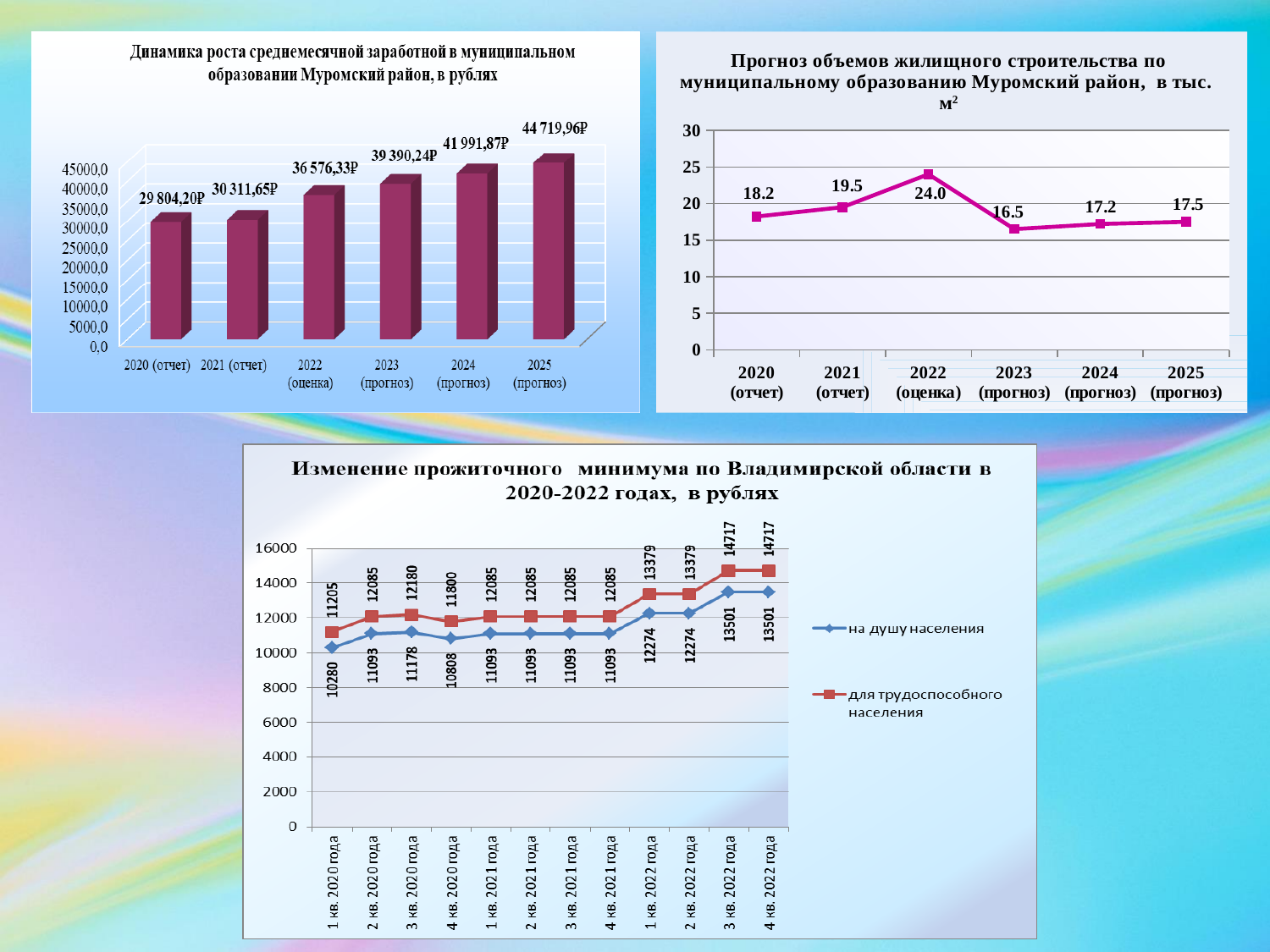
In the top-right chart (Прогноз объемов жилищного строительства), what is the difference between the 2022 value and the 2023 value? 7.5 In the top-right chart (Прогноз объемов жилищного строительства), which year has the highest value? 2022 (оценка) In the bottom chart (Изменение прожиточного минимума), what is the value for 'для трудоспособного населения' in 3 кв. 2022 года? 14717 In the top-right chart (Прогноз объемов жилищного строительства), what is the value for 2021 (отчет)? 19.5 In the top-right chart (Прогноз объемов жилищного строительства), which year has the lowest value? 2023 (прогноз) In the top-left chart (Динамика роста среднемесячной заработной платы), how many bars are plotted? 6 In the bottom chart (Изменение прожиточного минимума), how many series does the legend list? 2 In the top-left chart (Динамика роста среднемесячной заработной платы), do the values rise or fall from 2020 to 2025? Rise In the top-left chart (Динамика роста среднемесячной заработной платы), what is the value for 2025 (прогноз)? 44 719,96₽ In the top-left chart (Динамика роста среднемесячной заработной платы), what kind of chart is shown? Bar chart In the top-left chart (Динамика роста среднемесячной заработной платы), what is the value for 2020 (отчет)? 29 804,20₽ In the bottom chart (Изменение прожиточного минимума), which series is higher in 1 кв. 2020 года: 'на душу населения' or 'для трудоспособного населения'? для трудоспособного населения